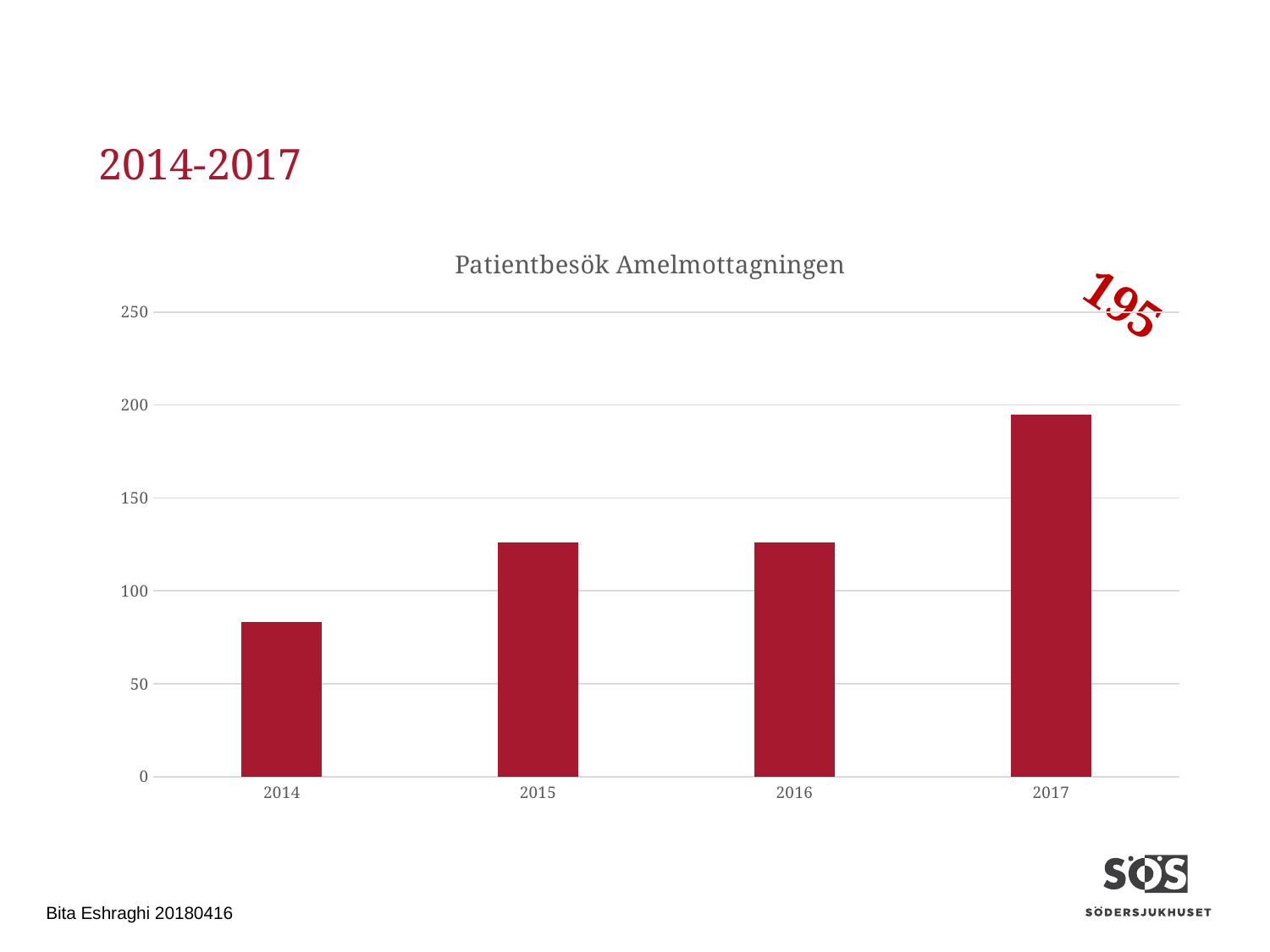
What kind of chart is shown on the slide? bar chart Which is larger, the value for 2014 or the value for 2017? 2017 Is the value for 2017 greater or less than 200? less Is the value for 2015 greater or less than 100? greater Which year has the highest number of patient visits? 2017 Do the values generally rise or fall from 2014 to 2017? rise Which year has the lowest number of patient visits? 2014 What value is annotated for 2017 on the chart? 195 What is the title of the chart? Patientbesök Amelmottagningen How many years are shown on the x axis of the chart? 4 Is the value for 2014 greater or less than 100? less